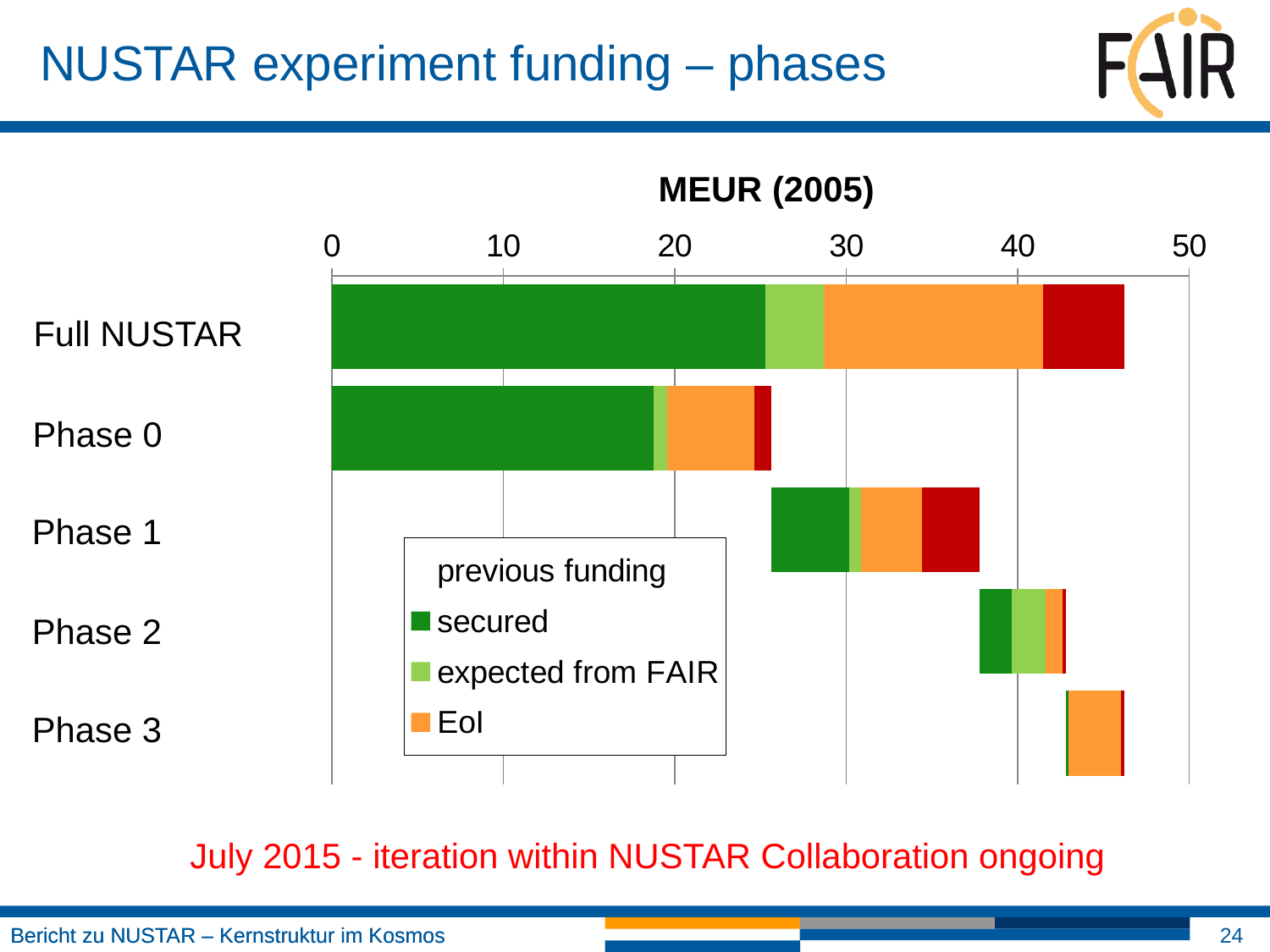
Which legend entry is shown in orange? EoI How many series does the chart legend list? 3 Which bar is longer, Phase 0 or Phase 1? Phase 0 Is the secured (dark green) segment of the Full NUSTAR bar greater or less than 20 MEUR? greater What kind of chart is shown on the slide? Stacked horizontal bar chart Which category has the longest bar? Full NUSTAR Is the secured (dark green) segment of the Phase 0 bar greater or less than 20 MEUR? less Which category has the shortest bar? Phase 3 Is the right end of the Full NUSTAR bar greater or less than 40 MEUR? greater What is the axis title shown above the chart? MEUR (2005) How many phase categories are plotted on the chart? 4